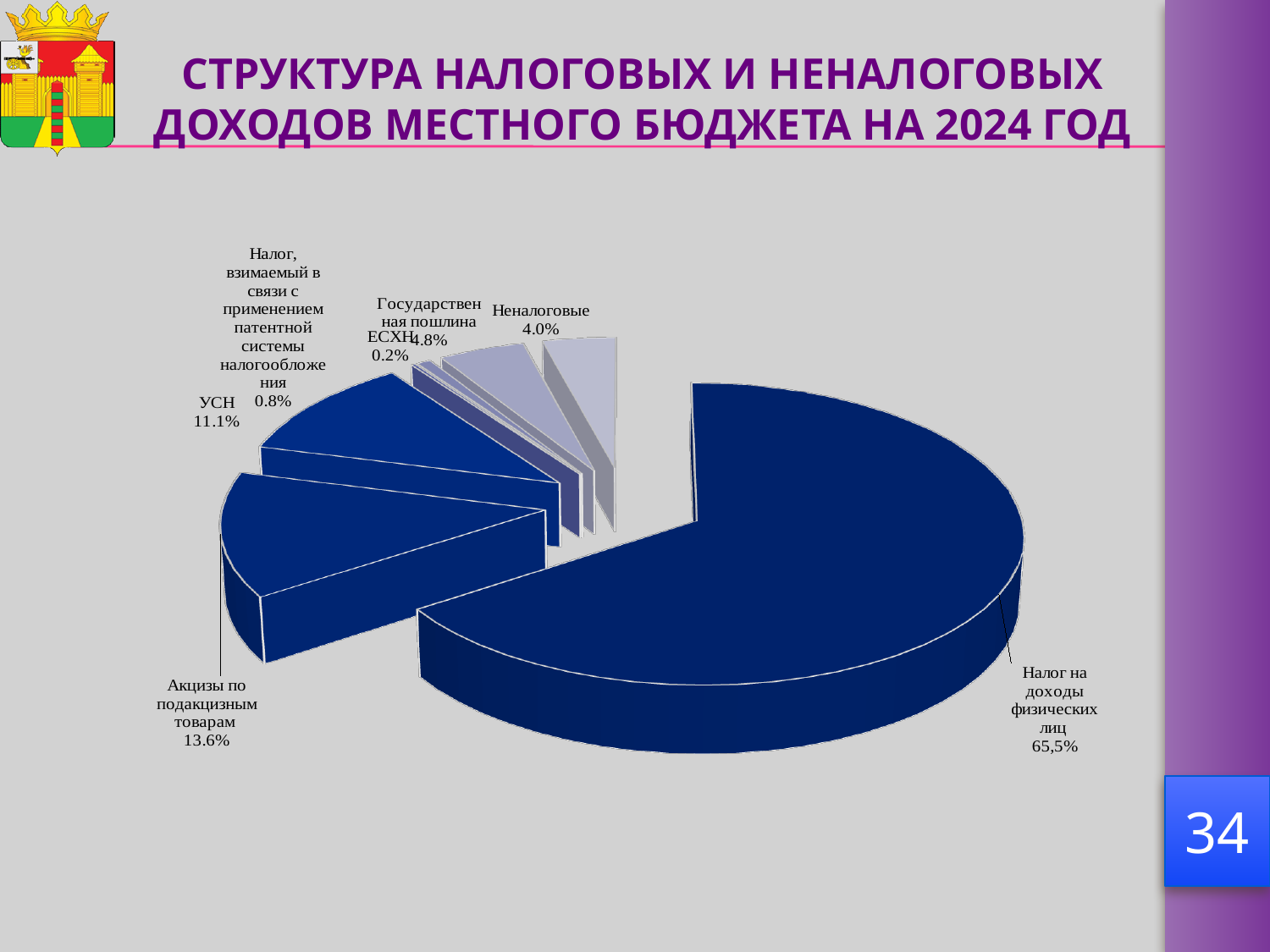
Which is larger, the share for "Акцизы по подакцизным товарам" or the share for "УСН"? Акцизы по подакцизным товарам How many slices does the pie chart have? 7 What is the value shown for "УСН"? 11.1% What is the difference between the shares for "Государственная пошлина" and "Неналоговые"? 0.8% What share of the pie does "Налог на доходы физических лиц" have? 65,5% What is the value shown for "Неналоговые"? 4.0% What is the value shown for "Акцизы по подакцизным товарам"? 13.6% What kind of chart is shown on the slide? Pie chart What is the value shown for "Государственная пошлина"? 4.8% What is the value shown for "ЕСХН"? 0.2% Which category has the smallest share of the pie? ЕСХН Which category has the largest share of the pie? Налог на доходы физических лиц